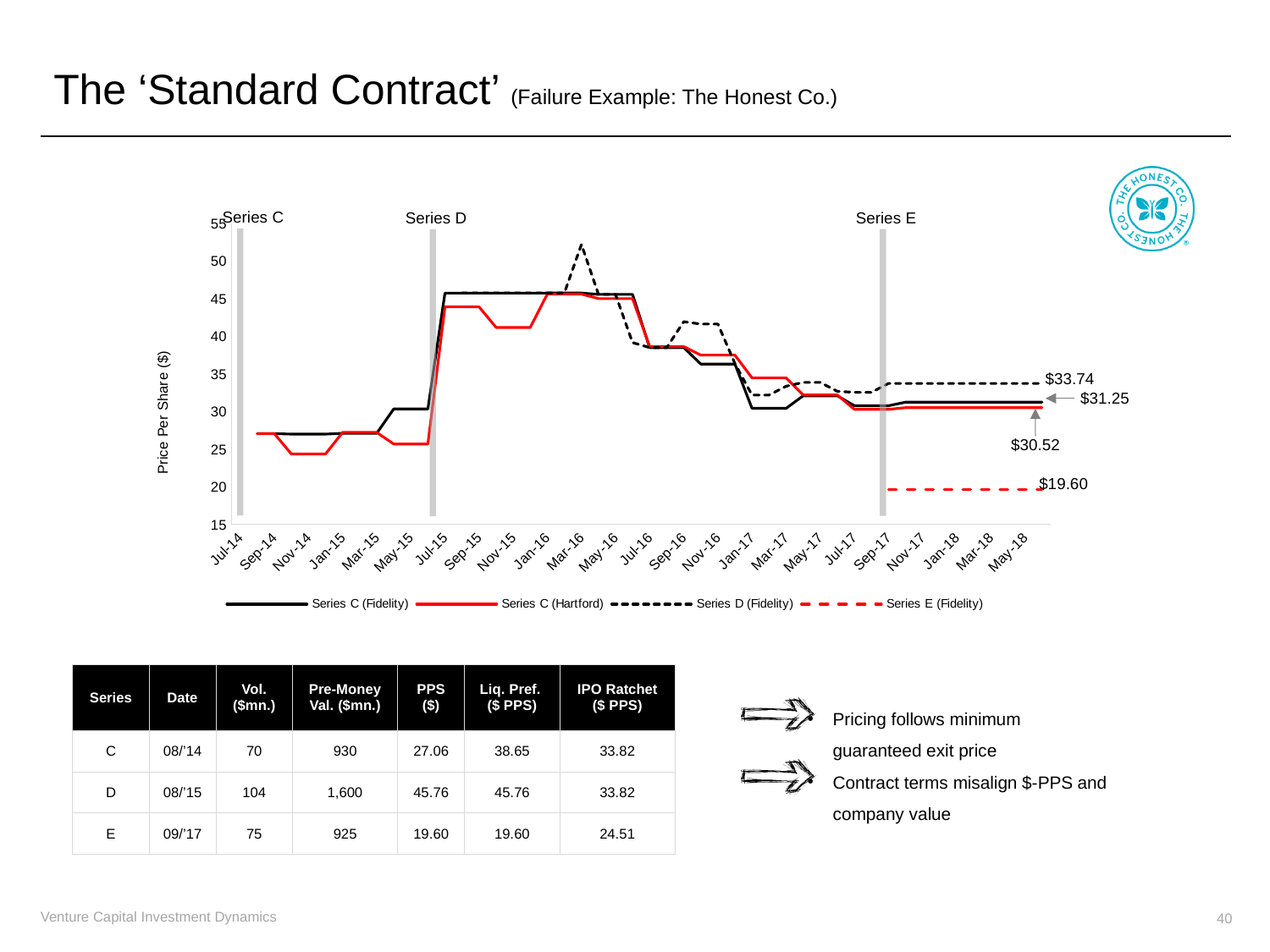
What kind of chart is shown on the slide? Line chart Is the peak value of the Series D (Fidelity) line around Mar-16 greater or less than 50? greater What is the final labelled value of the Series C (Fidelity) line? $31.25 What is the label on the vertical axis of the chart? Price Per Share ($) What is the final labelled value of the Series C (Hartford) line? $30.52 What is the labelled value of the Series E (Fidelity) line? $19.60 What is the difference between the labelled end values of Series D (Fidelity) and Series E (Fidelity)? $14.14 Which is larger at the end of the chart, the Series C (Fidelity) value or the Series C (Hartford) value? Series C (Fidelity) Which series has the lowest labelled end value on the chart? Series E (Fidelity) What is the final labelled value of the Series D (Fidelity) line? $33.74 Which series has the highest labelled end value on the chart? Series D (Fidelity) How many series does the legend list? 4